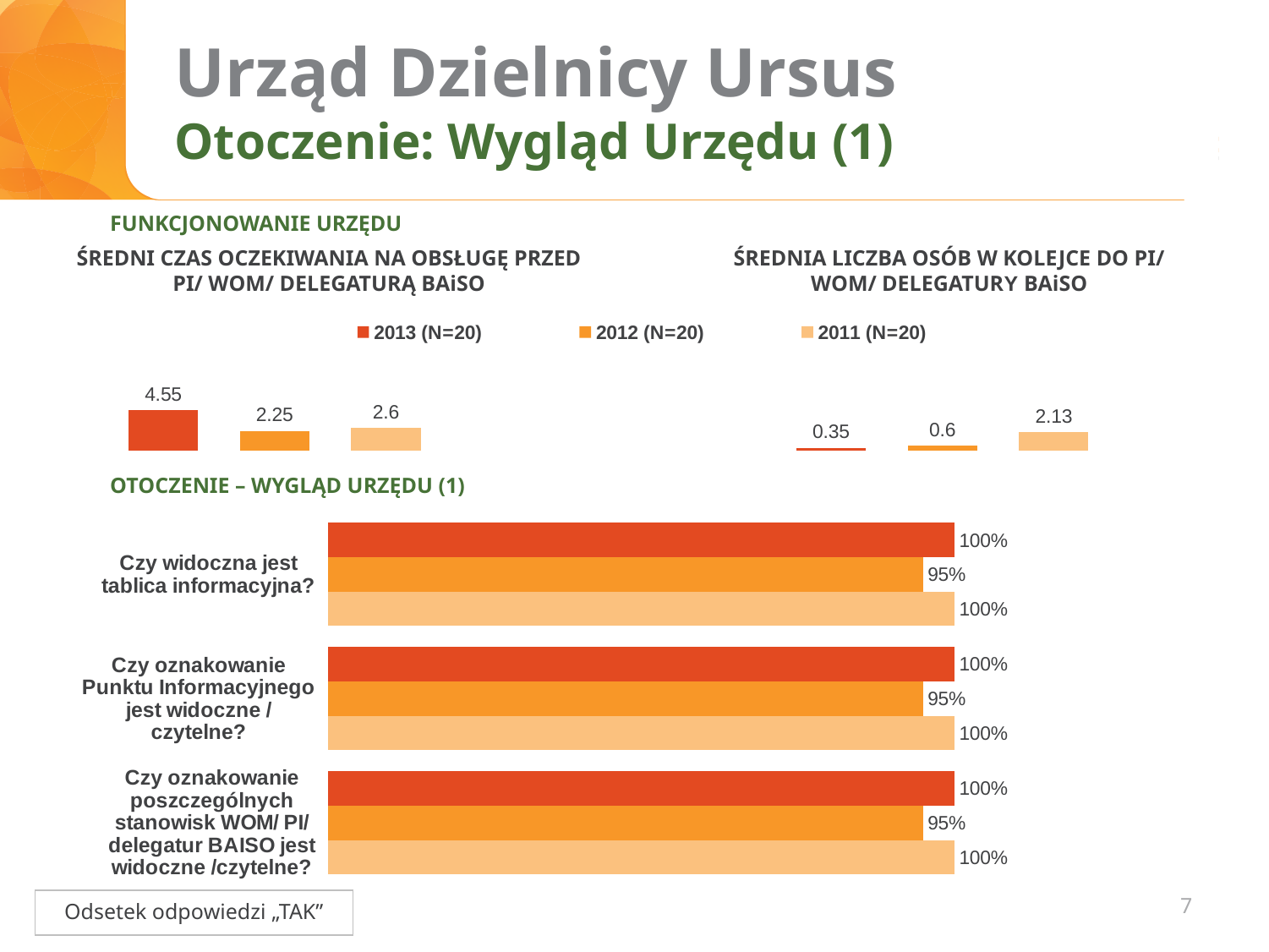
In the chart 'ŚREDNI CZAS OCZEKIWANIA NA OBSŁUGĘ PRZED PI/ WOM/ DELEGATURĄ BAiSO', which year has the lowest value? 2012 (N=20) In the chart 'ŚREDNIA LICZBA OSÓB W KOLEJCE DO PI/ WOM/ DELEGATURY BAiSO', which year has the highest value? 2011 (N=20) In the chart 'OTOCZENIE – WYGLĄD URZĘDU (1)', what is the 2012 (N=20) value for 'Czy widoczna jest tablica informacyjna?'? 95% What type of chart is 'OTOCZENIE – WYGLĄD URZĘDU (1)'? Bar chart How many question categories are shown in the chart 'OTOCZENIE – WYGLĄD URZĘDU (1)'? 3 How many series does the legend at the top of the slide list? 3 In the chart 'ŚREDNIA LICZBA OSÓB W KOLEJCE DO PI/ WOM/ DELEGATURY BAiSO', what is the value for 2013 (N=20)? 0.35 In the chart 'OTOCZENIE – WYGLĄD URZĘDU (1)', what is the 2013 (N=20) value for 'Czy oznakowanie Punktu Informacyjnego jest widoczne / czytelne?'? 100% In the chart 'ŚREDNI CZAS OCZEKIWANIA NA OBSŁUGĘ PRZED PI/ WOM/ DELEGATURĄ BAiSO', what is the value for 2013 (N=20)? 4.55 In the chart 'ŚREDNIA LICZBA OSÓB W KOLEJCE DO PI/ WOM/ DELEGATURY BAiSO', what is the value for 2011 (N=20)? 2.13 In the chart 'ŚREDNIA LICZBA OSÓB W KOLEJCE DO PI/ WOM/ DELEGATURY BAiSO', which is larger: the 2012 value or the 2013 value? 2012 (N=20) In the chart 'ŚREDNI CZAS OCZEKIWANIA NA OBSŁUGĘ PRZED PI/ WOM/ DELEGATURĄ BAiSO', what is the difference between the 2013 and 2011 values? 1.95